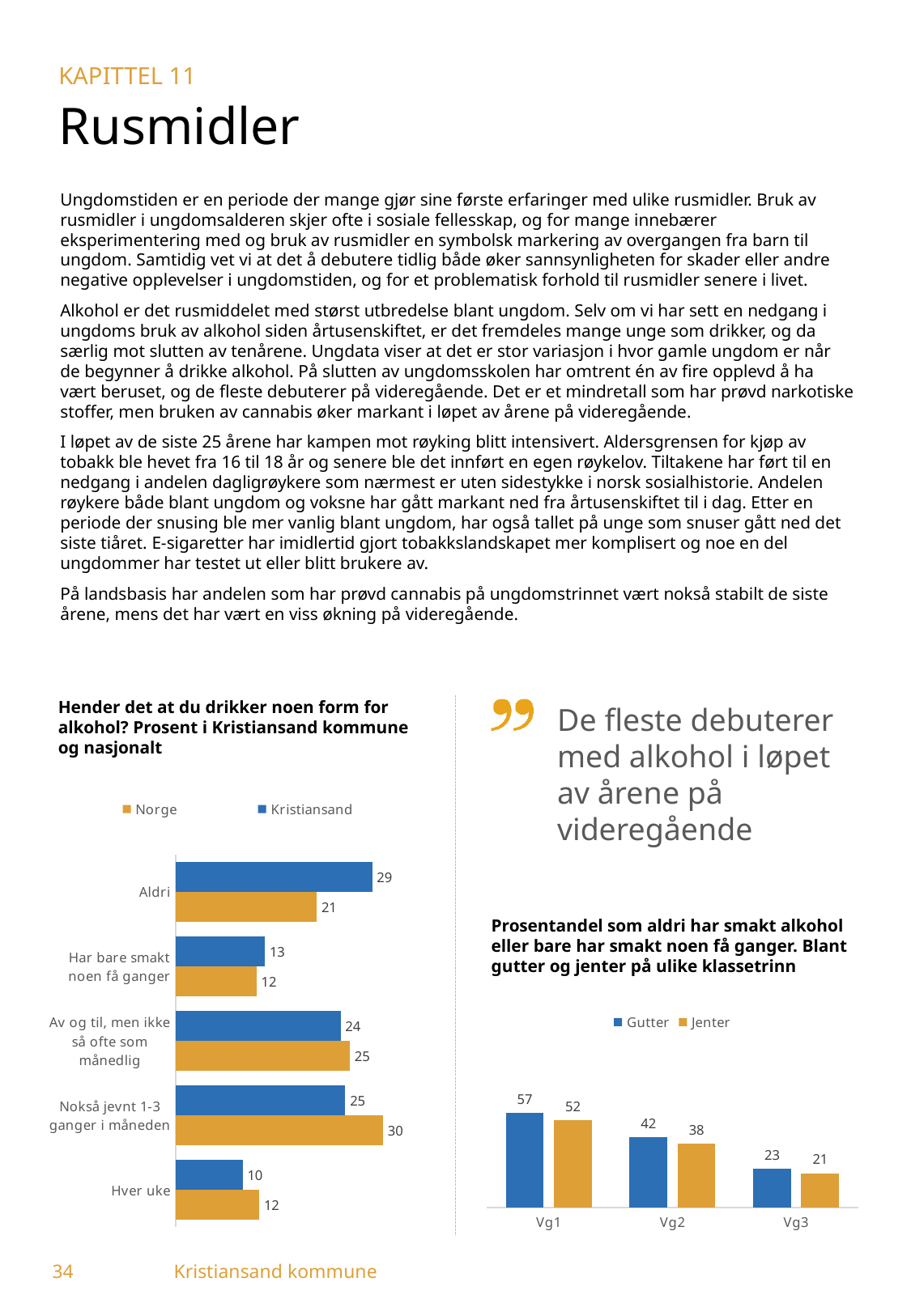
In the chart 'Hender det at du drikker noen form for alkohol?', which category has the lowest value for Kristiansand? Hver uke In the chart 'Hender det at du drikker noen form for alkohol?', which is larger for 'Hver uke': Norge or Kristiansand? Norge In the chart 'Prosentandel som aldri har smakt alkohol eller bare har smakt noen få ganger', which class level has the highest value for Gutter? Vg1 In the chart 'Hender det at du drikker noen form for alkohol?', how many categories are shown? 5 What kind of chart is the chart 'Prosentandel som aldri har smakt alkohol eller bare har smakt noen få ganger'? Bar chart In the chart 'Hender det at du drikker noen form for alkohol?', what is the value for Norge in the category 'Nokså jevnt 1-3 ganger i måneden'? 30 In the chart 'Prosentandel som aldri har smakt alkohol eller bare har smakt noen få ganger', what is the difference between Gutter and Jenter at Vg1? 5 In the chart 'Prosentandel som aldri har smakt alkohol eller bare har smakt noen få ganger', what is the value for Jenter at Vg2? 38 In the chart 'Hender det at du drikker noen form for alkohol?', what is the value for Kristiansand in the category 'Aldri'? 29 In the chart 'Hender det at du drikker noen form for alkohol?', how many series does the legend list? 2 In the chart 'Prosentandel som aldri har smakt alkohol eller bare har smakt noen få ganger', do the values for Gutter rise or fall from Vg1 to Vg3? Fall In the chart 'Hender det at du drikker noen form for alkohol?', what is the difference between the Kristiansand and Norge values for 'Aldri'? 8